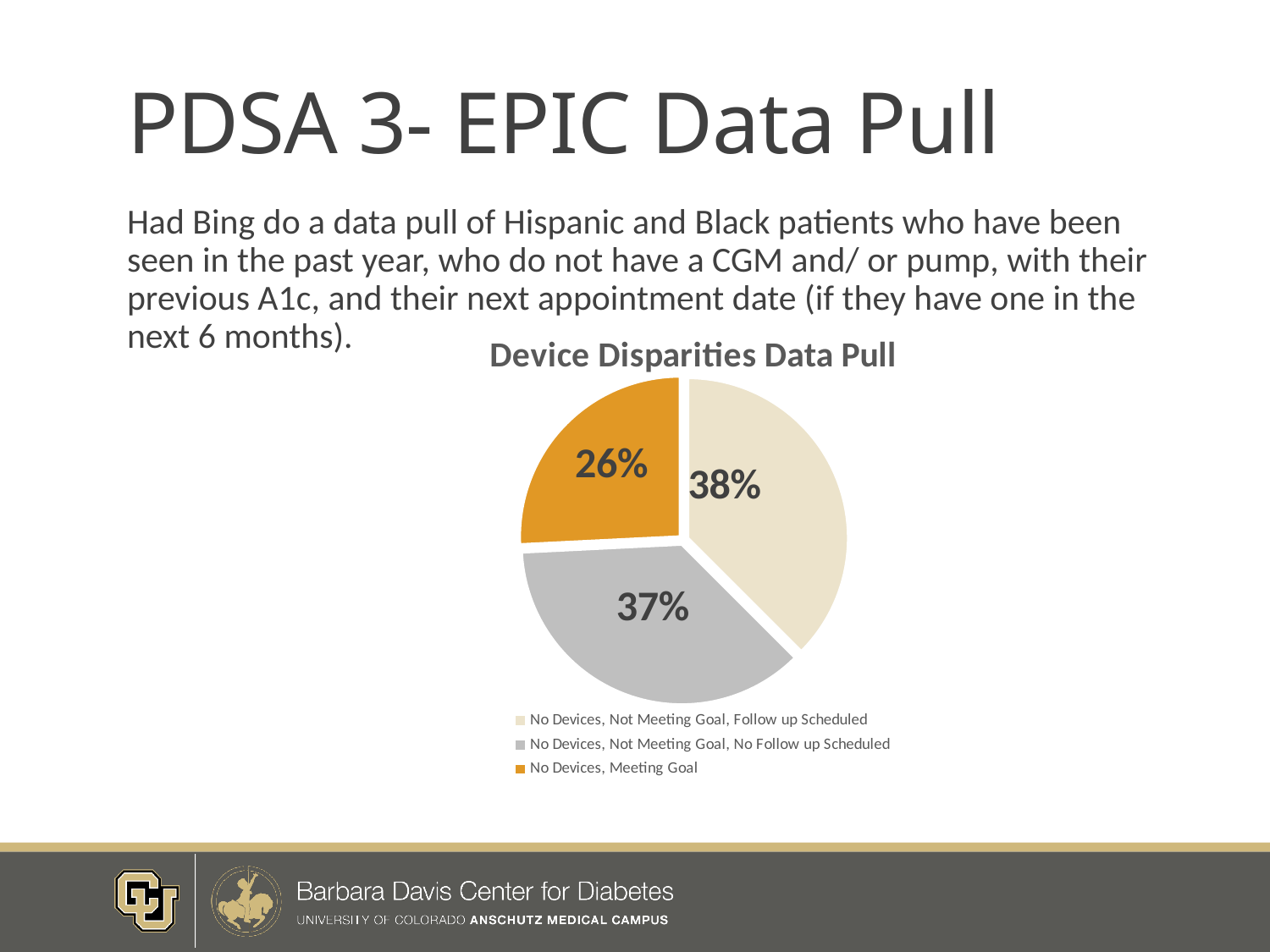
Which category has the smallest slice of the pie? No Devices, Meeting Goal Which category has the largest slice of the pie? No Devices, Not Meeting Goal, Follow up Scheduled How many slices does the pie chart have? 3 What percentage is shown for "No Devices, Not Meeting Goal, Follow up Scheduled"? 38% Which is larger: the slice for "No Devices, Not Meeting Goal, No Follow up Scheduled" or the slice for "No Devices, Meeting Goal"? No Devices, Not Meeting Goal, No Follow up Scheduled What is the difference in percentage points between "No Devices, Not Meeting Goal, No Follow up Scheduled" and "No Devices, Meeting Goal"? 11 What share of the pie is labelled "No Devices, Meeting Goal"? 26% What percentage is shown for "No Devices, Not Meeting Goal, No Follow up Scheduled"? 37% What is the title of the chart? Device Disparities Data Pull What is the difference in percentage points between "No Devices, Not Meeting Goal, Follow up Scheduled" and "No Devices, Meeting Goal"? 12 What colour is the slice for "No Devices, Meeting Goal"? Orange What kind of chart is shown on the slide? Pie chart